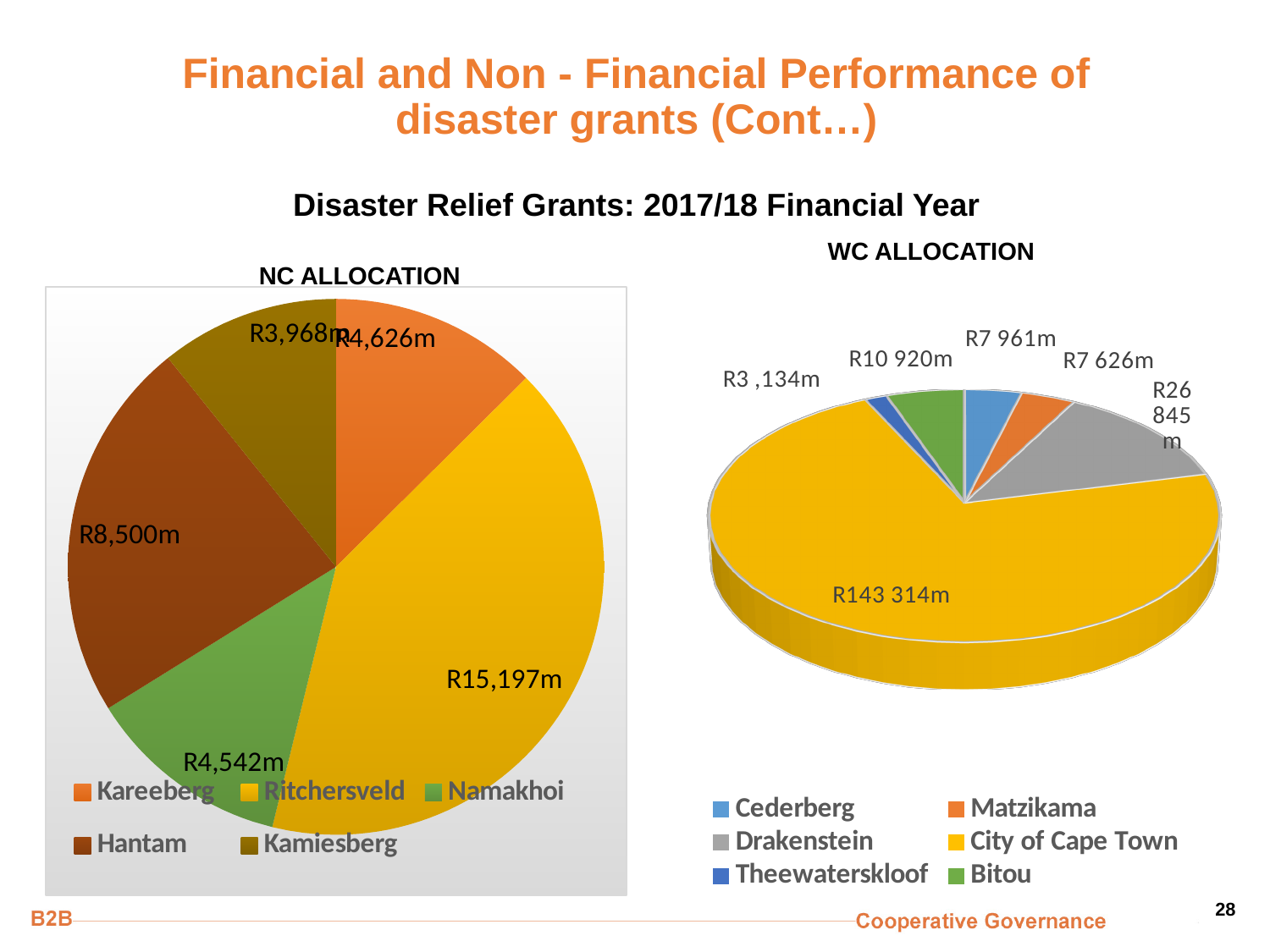
On the WC ALLOCATION chart, which municipality has the smallest allocation? Theewaterskloof On the WC ALLOCATION chart, which municipality has the largest allocation? City of Cape Town What type of chart is the WC ALLOCATION chart? Pie chart On the WC ALLOCATION chart, how many municipalities does the legend list? 6 On the WC ALLOCATION chart, which is larger, the allocation for Drakenstein or for Bitou? Drakenstein On the NC ALLOCATION chart, what is the value for Ritchersveld? R15,197m On the WC ALLOCATION chart, what is the value for City of Cape Town? R143 314m On the NC ALLOCATION chart, which municipality has the smallest allocation? Kamiesberg On the NC ALLOCATION chart, what is the value for Hantam? R8,500m On the WC ALLOCATION chart, what is the value for Drakenstein? R26 845m On the NC ALLOCATION chart, how many municipalities are shown? 5 On the NC ALLOCATION chart, what is the difference between the Hantam and Kareeberg allocations? R3,874m